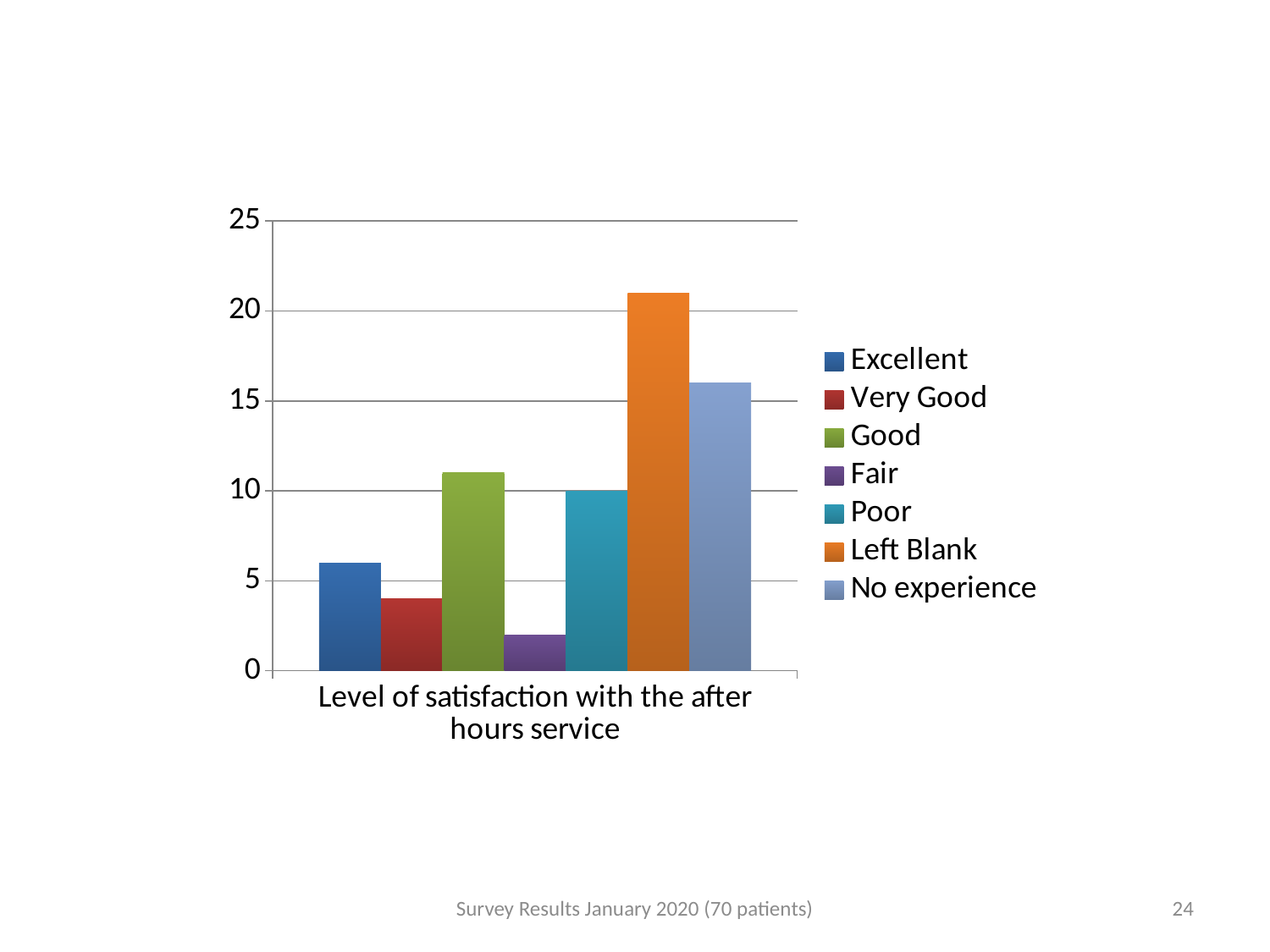
What is the value for Poor? 10 What kind of chart is shown on the slide? bar chart Which is larger, the value for No experience or the value for Left Blank? Left Blank Is the value for Very Good greater or less than 5? less Is the value for Excellent greater or less than 5? greater Is the value for No experience greater or less than 15? greater Which is larger, the value for Good or the value for Excellent? Good Which series has the lowest value? Fair How many series does the legend list? 7 Which series has the highest value? Left Blank What is the category label shown on the x axis? Level of satisfaction with the after hours service